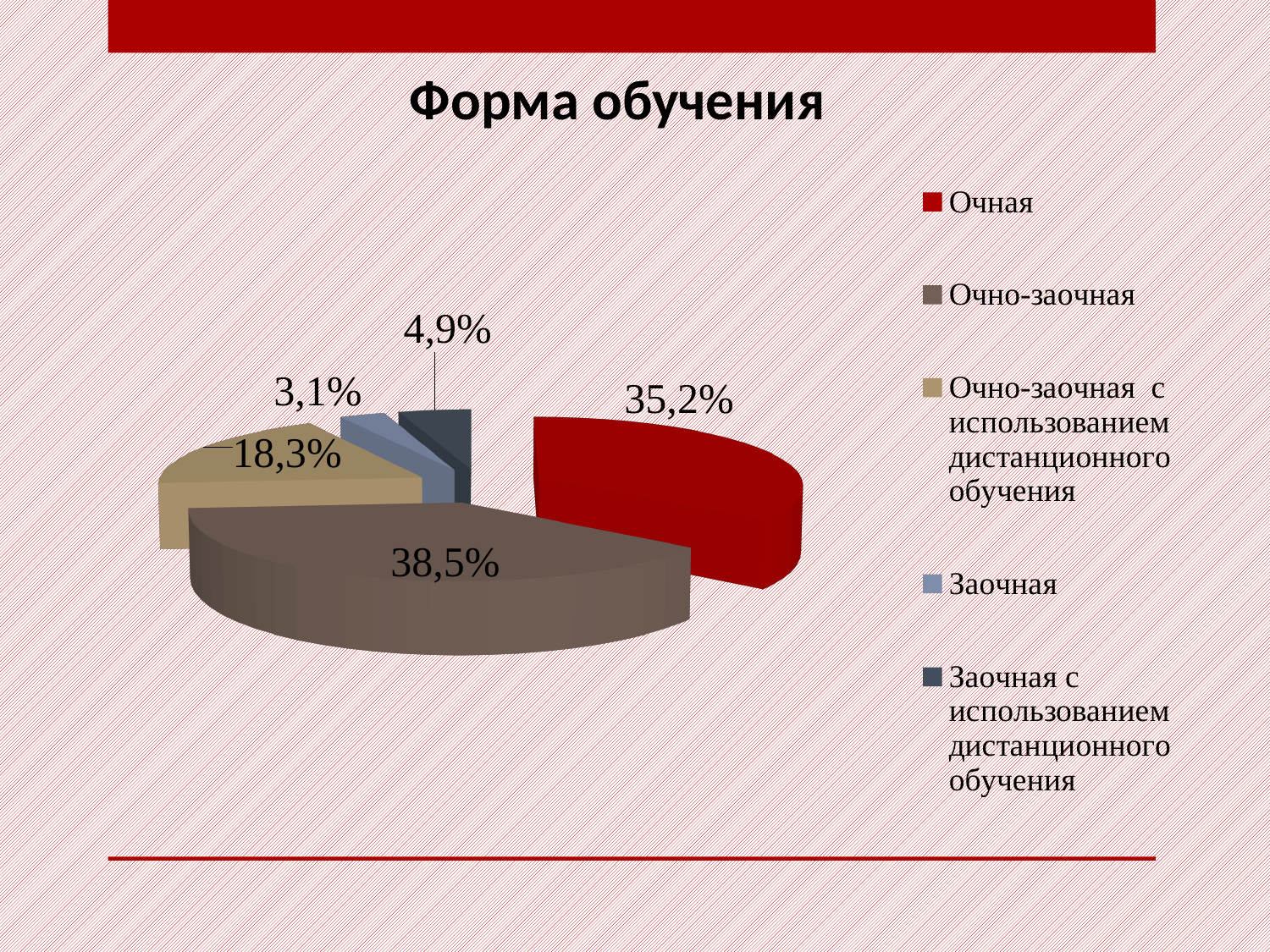
Which colour represents Очная in the chart? Red What share of the pie is labelled for Очно-заочная? 38,5% What is the title of the chart? Форма обучения How many categories does the legend list? 5 What is the difference in percentage points between Очно-заочная and Очная? 3,3 What kind of chart is shown on the slide? Pie chart What share of the pie is labelled for Очная? 35,2% What share of the pie is labelled for Заочная с использованием дистанционного обучения? 4,9% What share of the pie is labelled for Очно-заочная с использованием дистанционного обучения? 18,3% Which category has the largest share of the pie? Очно-заочная What share of the pie is labelled for Заочная? 3,1% Which category has the smallest share of the pie? Заочная